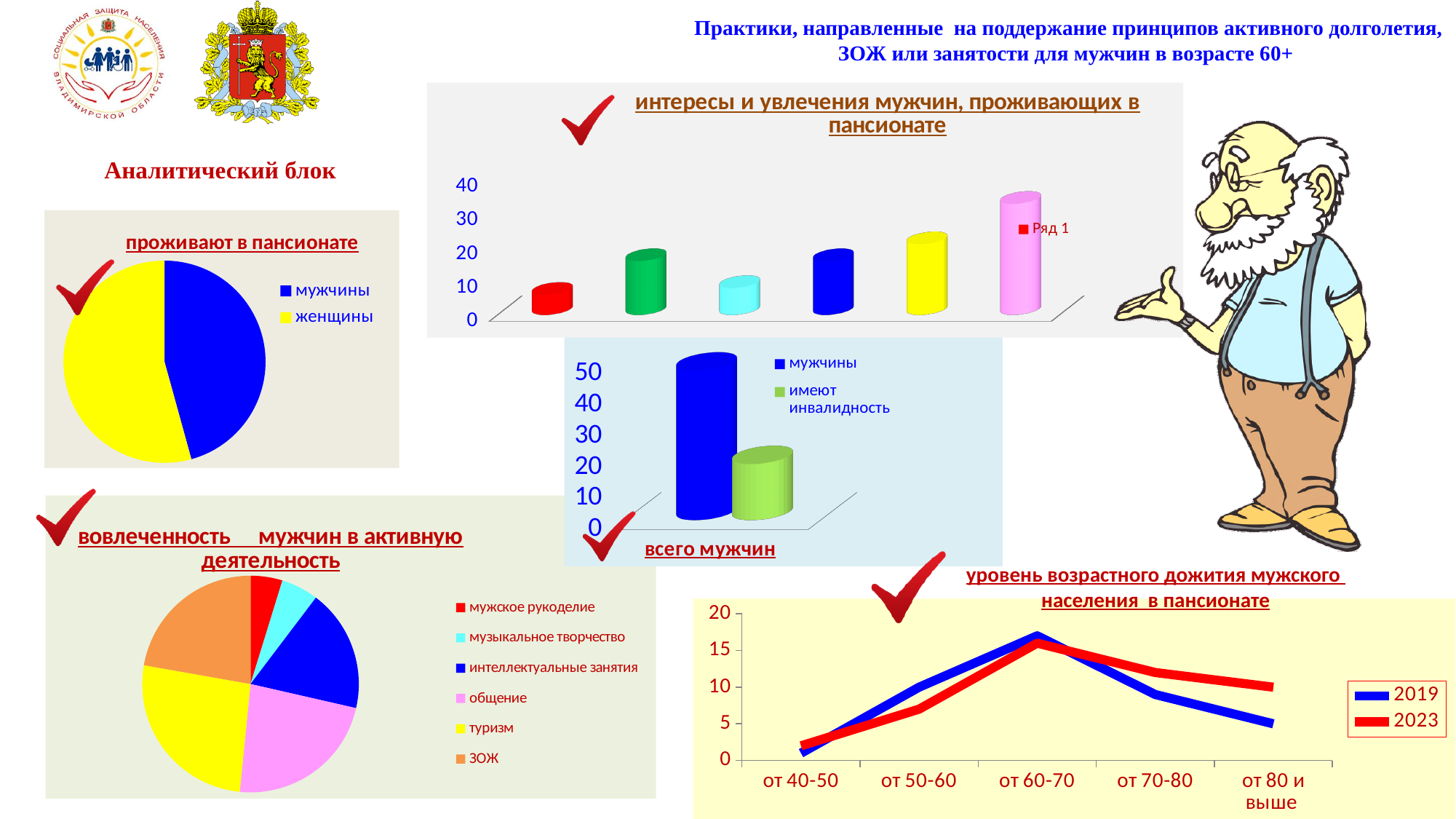
In the 'всего мужчин' chart, which bar is taller, мужчины or 'имеют инвалидность'? мужчины What kind of chart is the 'проживают в пансионате' chart? pie chart In the 'уровень возрастного дожития мужского населения в пансионате' chart, which age group has the highest value for 2019? от 60-70 In the 'уровень возрастного дожития мужского населения в пансионате' chart, is the 2019 value for 'от 80 и выше' greater or less than 10? less What is the legend entry shown in the 'интересы и увлечения мужчин, проживающих в пансионате' chart? Ряд 1 In the 'проживают в пансионате' pie chart, which group has the larger share, мужчины or женщины? женщины In the 'всего мужчин' chart, is the value for мужчины greater or less than 40? greater How many series does the legend of the 'уровень возрастного дожития мужского населения в пансионате' chart list? 2 In the 'всего мужчин' chart, is the value for 'имеют инвалидность' greater or less than 30? less How many bars are plotted in the 'интересы и увлечения мужчин, проживающих в пансионате' chart? 6 In the 'вовлеченность мужчин в активную деятельность' pie chart, which slice is larger, туризм or мужское рукоделие? туризм How many slices does the 'вовлеченность мужчин в активную деятельность' pie chart have? 6